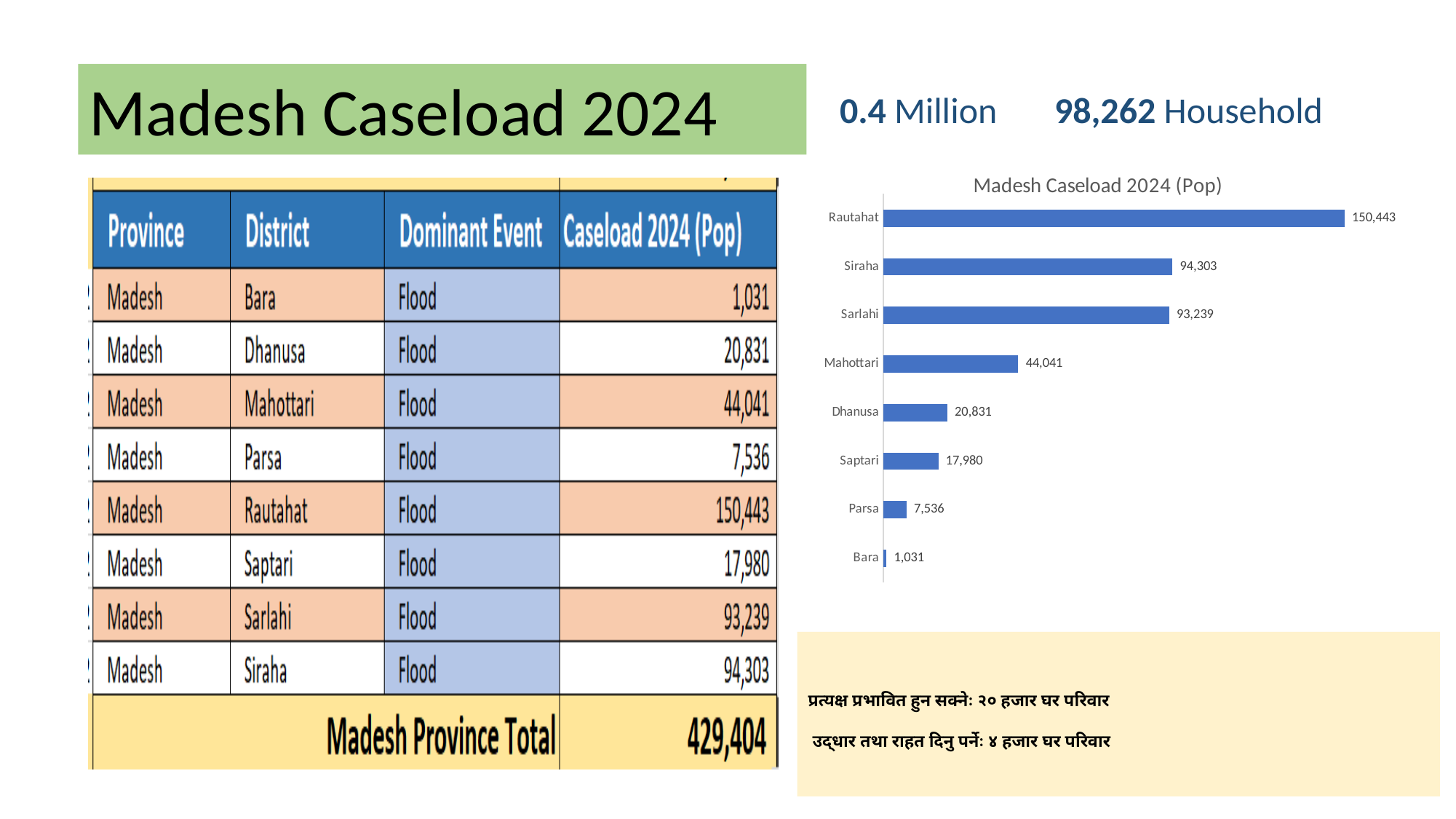
What is the caseload value for Rautahat in the chart? 150,443 What is the caseload value for Mahottari in the chart? 44,041 What kind of chart is shown on the slide? Bar chart Which district has the highest caseload in the chart? Rautahat What is the caseload value for Saptari in the chart? 17,980 Which district has the lowest caseload in the chart? Bara What is the title of the chart? Madesh Caseload 2024 (Pop) What is the difference between the caseload values for Rautahat and Mahottari? 106,402 Which has a larger caseload, Dhanusa or Saptari? Dhanusa What is the difference between the caseload values for Siraha and Sarlahi? 1,064 How many districts are shown in the chart? 8 Which has a larger caseload, Parsa or Bara? Parsa